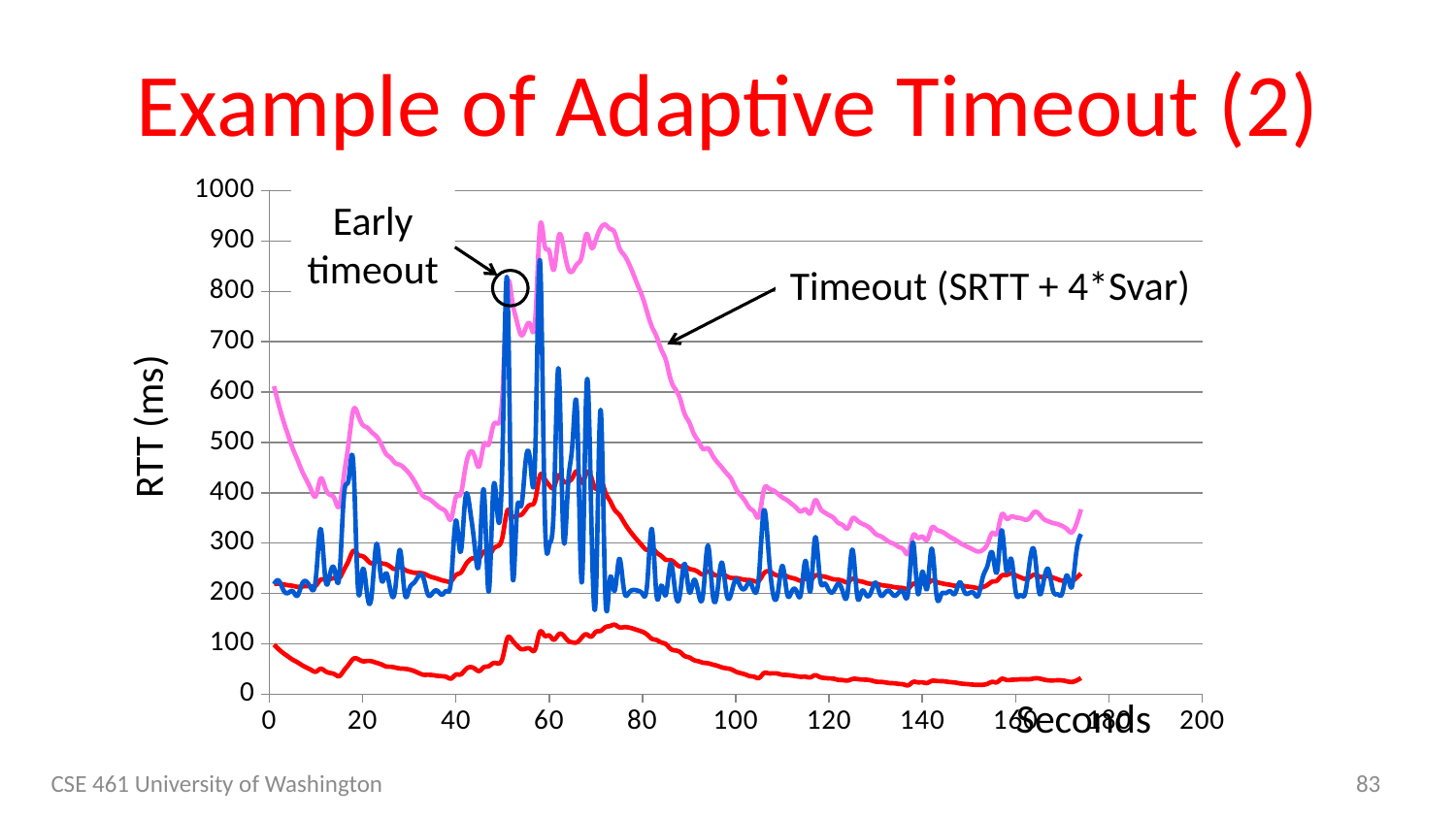
How many lines are plotted on the chart? 4 Does the Timeout (SRTT + 4*Svar) line rise or fall between 80 and 100 seconds? fall Is the value of the Timeout (SRTT + 4*Svar) line at 40 seconds greater or less than 500? less Is the value of the Timeout (SRTT + 4*Svar) line at 70 seconds greater or less than 800? greater Is the value of the Timeout (SRTT + 4*Svar) line at 20 seconds greater or less than 500? greater Does the Timeout (SRTT + 4*Svar) line rise or fall between 40 and 60 seconds? rise What is the title of the chart on the slide? Example of Adaptive Timeout (2) What kind of chart is shown on the slide? line chart Is the Timeout (SRTT + 4*Svar) line higher at 70 seconds or at 140 seconds? 70 seconds What is the label on the vertical axis of the chart? RTT (ms)